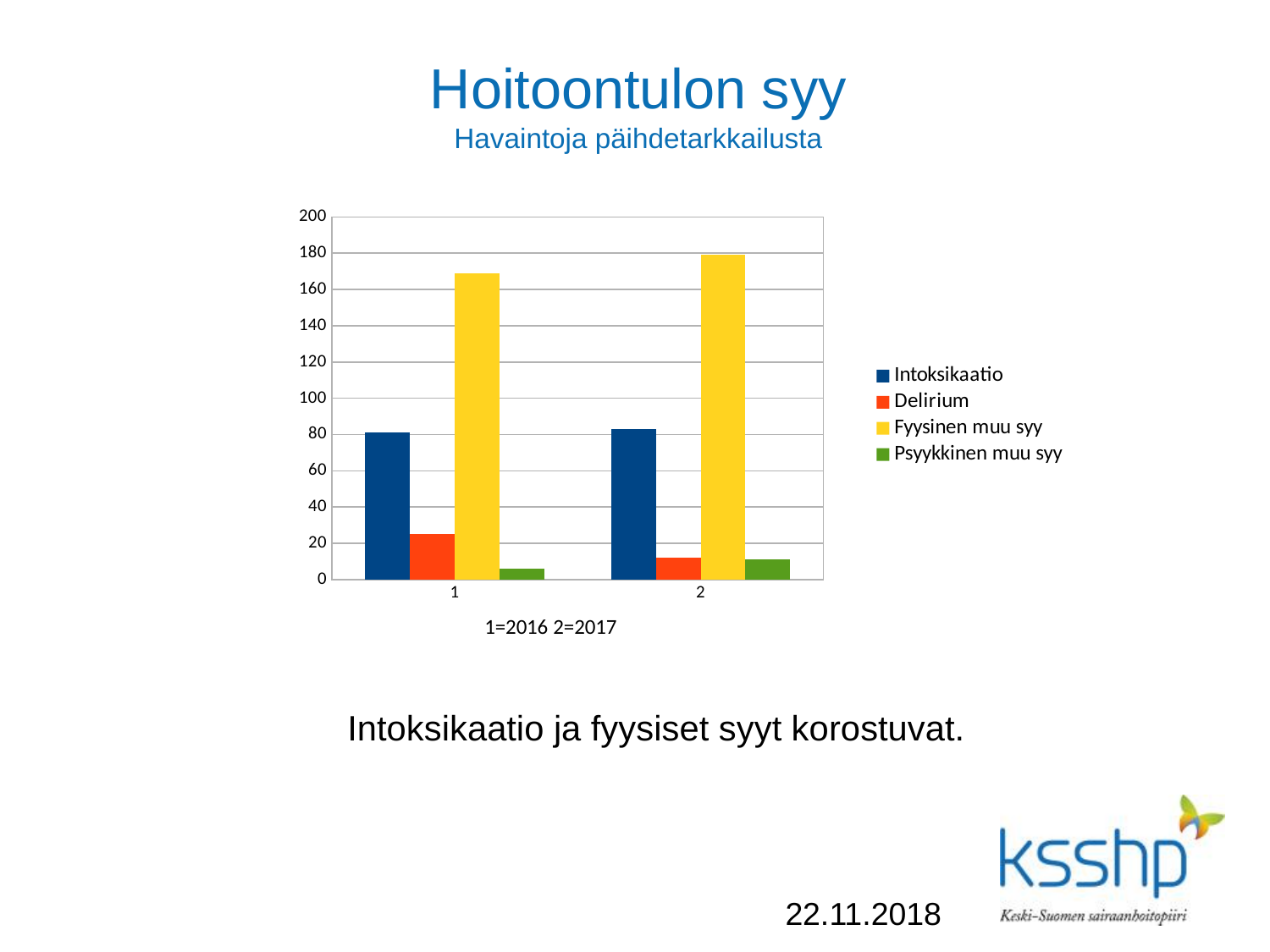
Which series has the highest value in category 1? Fyysinen muu syy Is the value for Psyykkinen muu syy in category 1 greater or less than 20? less Is the value for Fyysinen muu syy in category 1 greater or less than 160? greater Which is larger: Delirium in category 1 or Delirium in category 2? Delirium in category 1 What kind of chart is shown on the slide? bar chart How many series does the legend list? 4 Which series has the lowest value in category 1? Psyykkinen muu syy Which series has the lowest value in category 2? Psyykkinen muu syy Is the value for Intoksikaatio in category 2 greater or less than 60? greater According to the note below the x axis, which year does category 2 represent? 2017 How many categories are shown on the x axis? 2